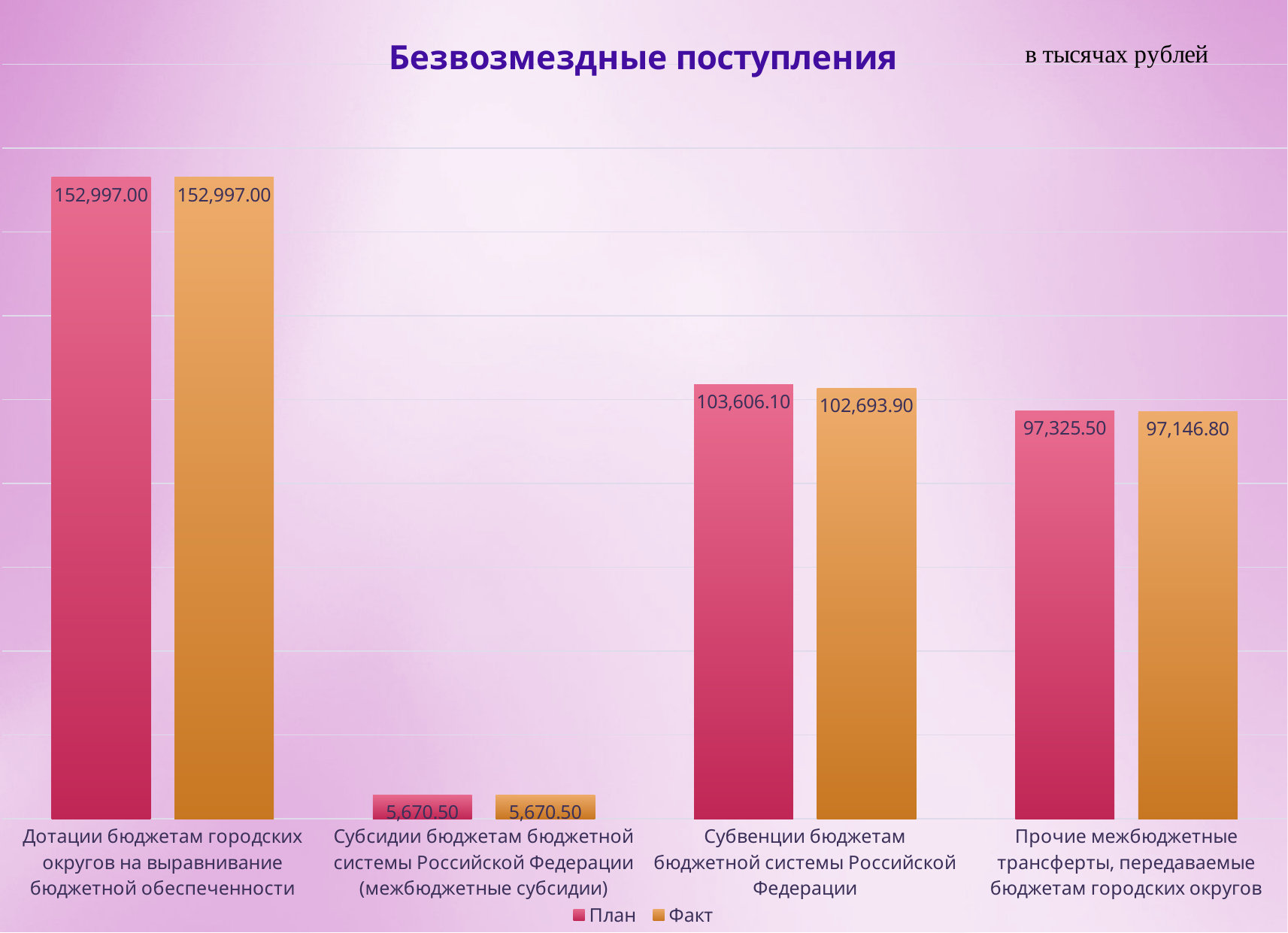
What is the Факт value for Субсидии бюджетам бюджетной системы Российской Федерации (межбюджетные субсидии)? 5,670.50 Which is larger: the План value for Субвенции бюджетам бюджетной системы Российской Федерации or the План value for Прочие межбюджетные трансферты, передаваемые бюджетам городских округов? Субвенции бюджетам бюджетной системы Российской Федерации Which category has the lowest План value? Субсидии бюджетам бюджетной системы Российской Федерации (межбюджетные субсидии) What is the План value for Дотации бюджетам городских округов на выравнивание бюджетной обеспеченности? 152,997.00 What is the difference between the План and Факт values for Субвенции бюджетам бюджетной системы Российской Федерации? 912.20 Which category has the highest Факт value? Дотации бюджетам городских округов на выравнивание бюджетной обеспеченности How many categories are shown on the x axis? 4 What is the Факт value for Субвенции бюджетам бюджетной системы Российской Федерации? 102,693.90 What is the План value for Прочие межбюджетные трансферты, передаваемые бюджетам городских округов? 97,325.50 What is the difference between the План and Факт values for Прочие межбюджетные трансферты, передаваемые бюджетам городских округов? 178.70 How many series does the legend list? 2 What type of chart is shown on the slide? Bar chart